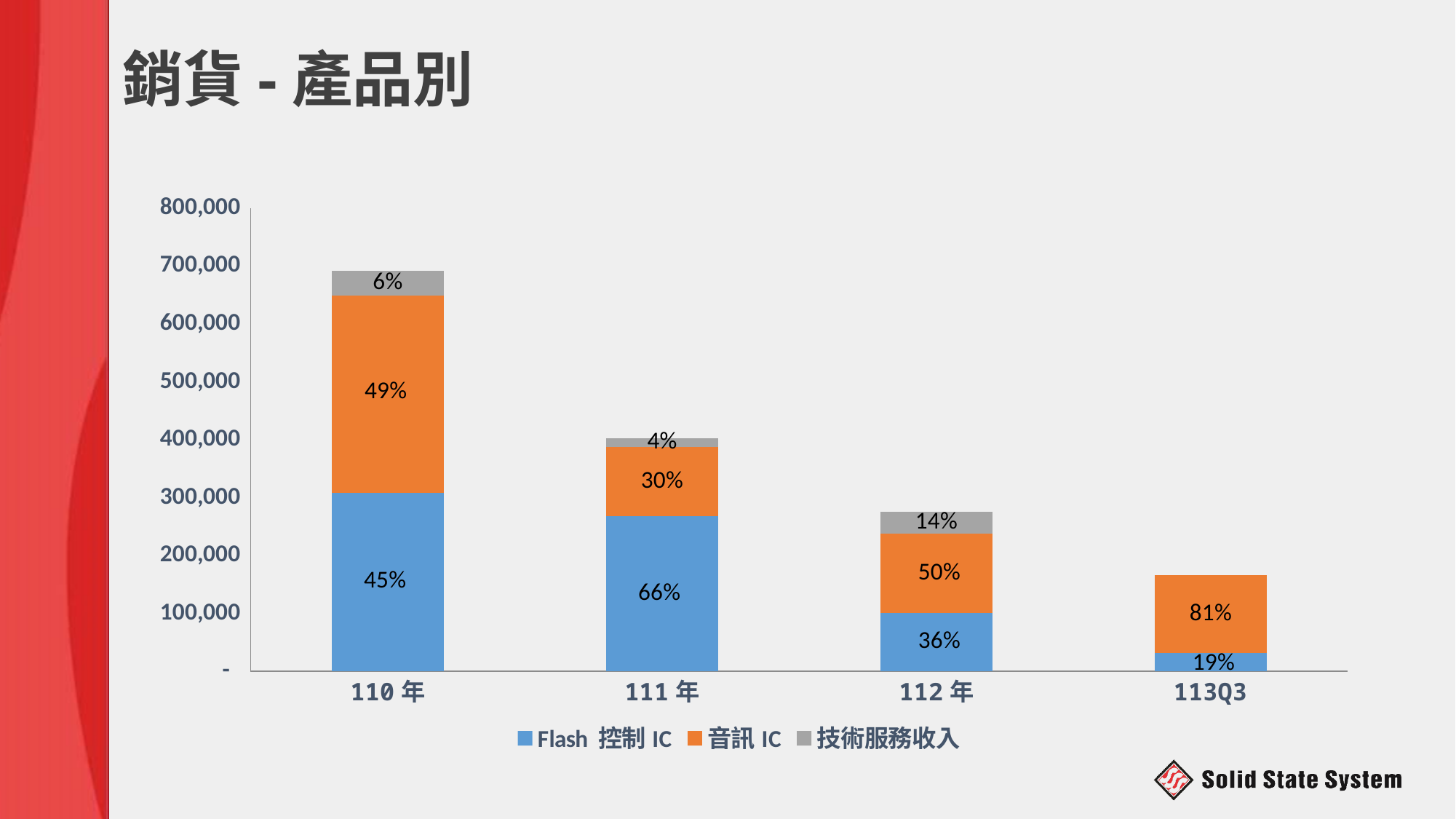
What type of chart is shown on the slide? stacked bar chart Which category has the highest total bar? 110 年 Which category has the lowest total bar? 113Q3 What is the labelled share of 音訊 IC in 113Q3? 81% How many categories are shown on the x axis? 4 What is the labelled share of Flash 控制 IC in 110 年? 45% What is the labelled share of 技術服務收入 in 112 年? 14% What is the labelled share of 音訊 IC in 111 年? 30% How many series does the legend list? 3 Do the total bar heights rise or fall from 110 年 to 113Q3? fall Is the total value for 113Q3 greater or less than 200,000? less Is the total value for 110 年 greater or less than 600,000? greater